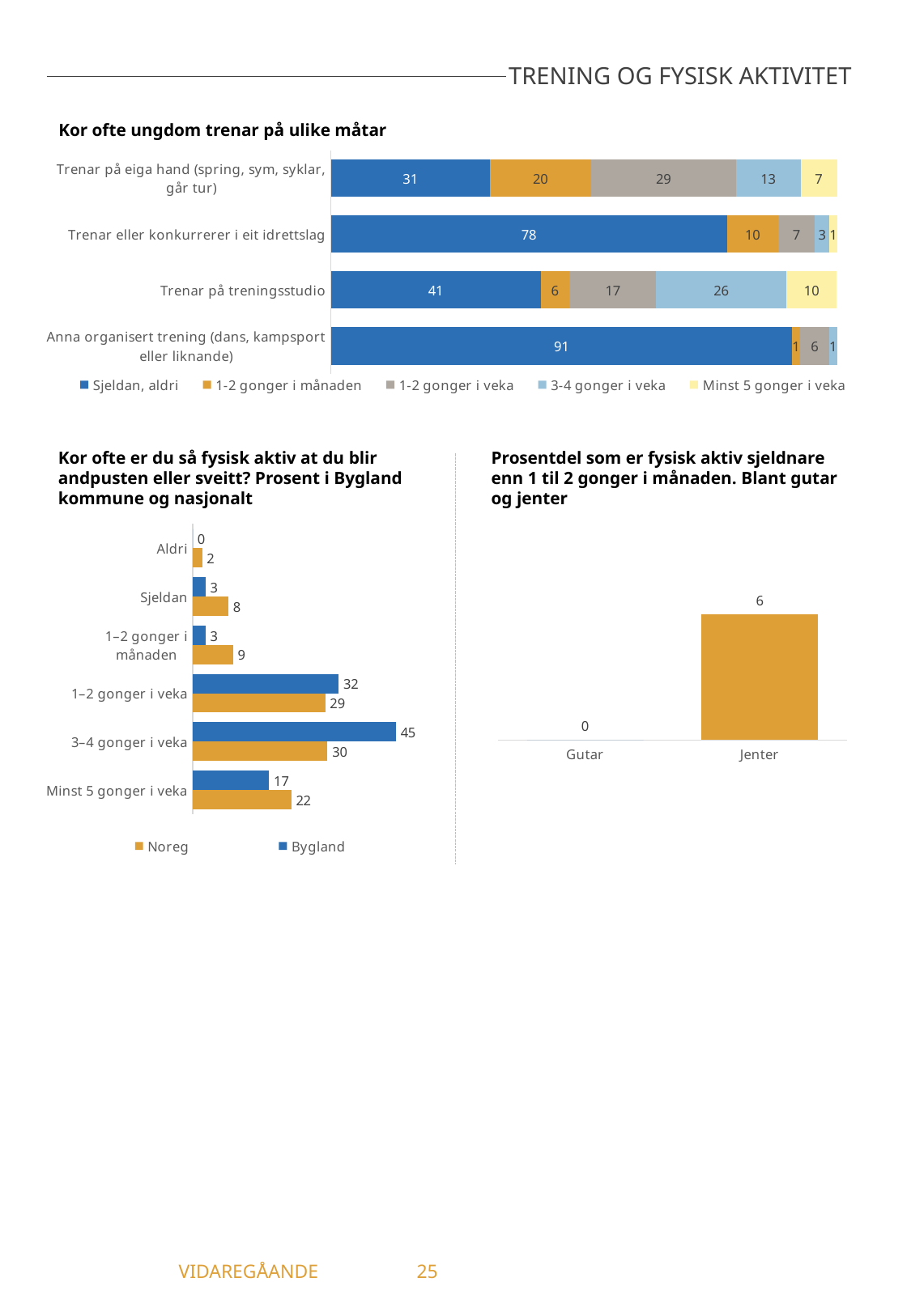
In the chart 'Kor ofte er du så fysisk aktiv at du blir andpusten eller sveitt?', what is the Noreg value for 'Minst 5 gonger i veka'? 22 In the chart 'Prosentdel som er fysisk aktiv sjeldnare enn 1 til 2 gonger i månaden', what is the value for Jenter? 6 In the chart 'Kor ofte er du så fysisk aktiv at du blir andpusten eller sveitt?', what is the Bygland value for '3–4 gonger i veka'? 45 In the chart 'Kor ofte ungdom trenar på ulike måtar', what is the total of the stacked bar for 'Trenar på eiga hand (spring, sym, syklar, går tur)'? 100 In the chart 'Kor ofte er du så fysisk aktiv at du blir andpusten eller sveitt?', which is larger for 'Sjeldan': Noreg or Bygland? Noreg In the chart 'Kor ofte ungdom trenar på ulike måtar', which category has the highest 'Sjeldan, aldri' value? Anna organisert trening (dans, kampsport eller liknande) In the chart 'Kor ofte ungdom trenar på ulike måtar', how many series does the legend list? 5 In the chart 'Kor ofte er du så fysisk aktiv at du blir andpusten eller sveitt?', what is the difference between the Bygland and Noreg values for '3–4 gonger i veka'? 15 In the chart 'Kor ofte ungdom trenar på ulike måtar', what is the value of '3-4 gonger i veka' for 'Trenar på treningsstudio'? 26 In the chart 'Kor ofte ungdom trenar på ulike måtar', what kind of chart is shown? Stacked bar chart In the chart 'Kor ofte er du så fysisk aktiv at du blir andpusten eller sveitt?', how many categories are shown? 6 In the chart 'Kor ofte ungdom trenar på ulike måtar', what is the value of 'Sjeldan, aldri' for 'Trenar eller konkurrerer i eit idrettslag'? 78